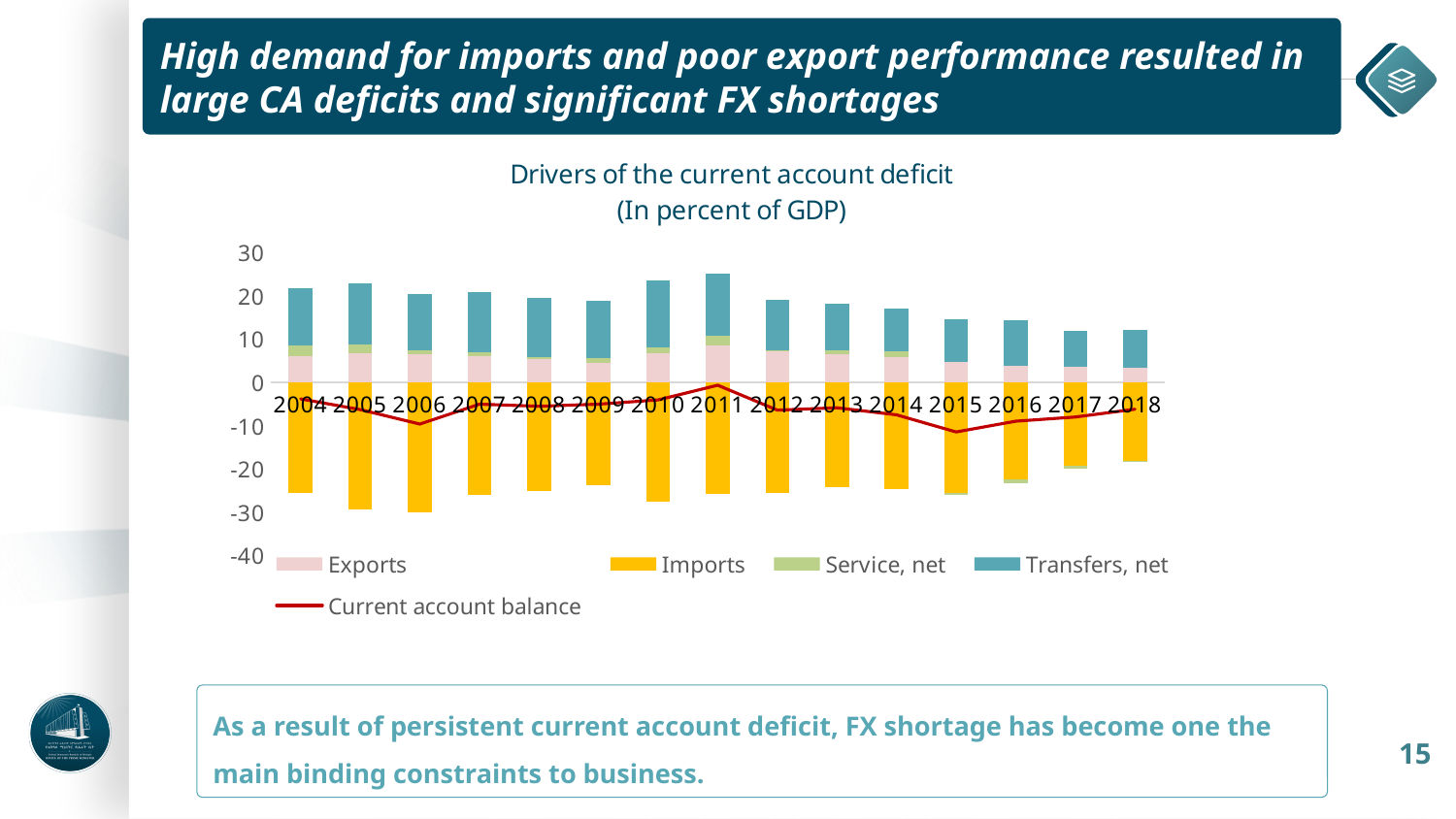
How many years are shown on the x axis of the chart? 15 In what units are the values on the chart expressed, according to the subtitle? In percent of GDP Is the Imports value for 2006 greater or less than -20? less Is the Current account balance for 2011 greater or less than -10? greater Does the top of the stacked bar above zero rise or fall from 2011 to 2018? fall Is the Imports value for 2017 greater or less than -30? greater What is the title of the chart? Drivers of the current account deficit How many series does the legend list? 5 In which year is the Current account balance line at its highest point? 2011 Which year has the longer Imports bar, 2006 or 2017? 2006 What kind of chart is shown on the slide? stacked bar chart with a line In which year does the stacked bar above zero reach its highest point? 2011